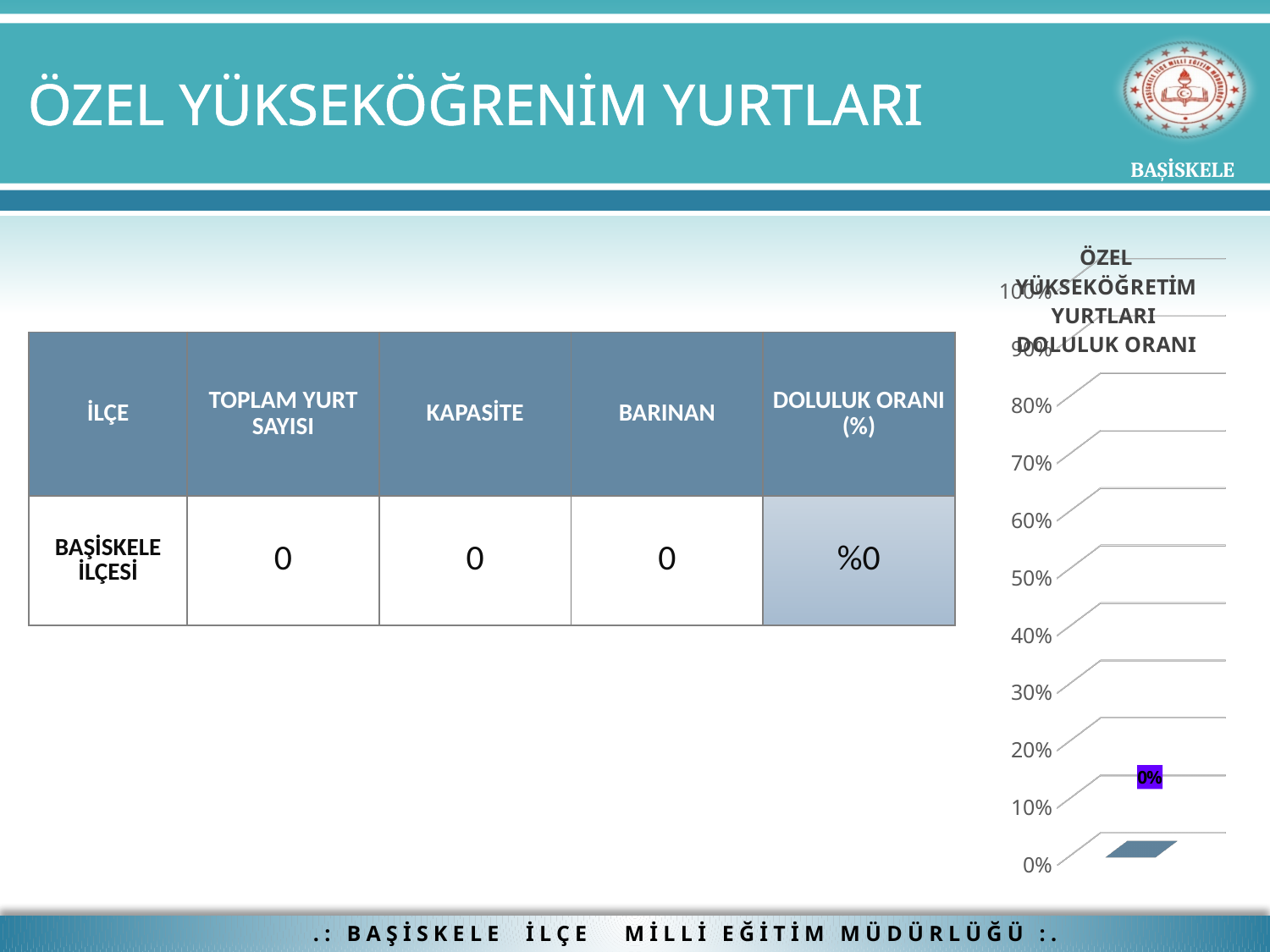
What is the highest value shown on the vertical axis of the chart? 100% What kind of chart is shown on the right side of the slide? bar chart Is the value of the bar in the chart greater or less than 10%? less What value does the data label on the bar in the chart show? 0% Is the value of the bar in the chart greater or less than 50%? less What is the title of the chart on the right side of the slide? ÖZEL YÜKSEKÖĞRETİM YURTLARI DOLULUK ORANI